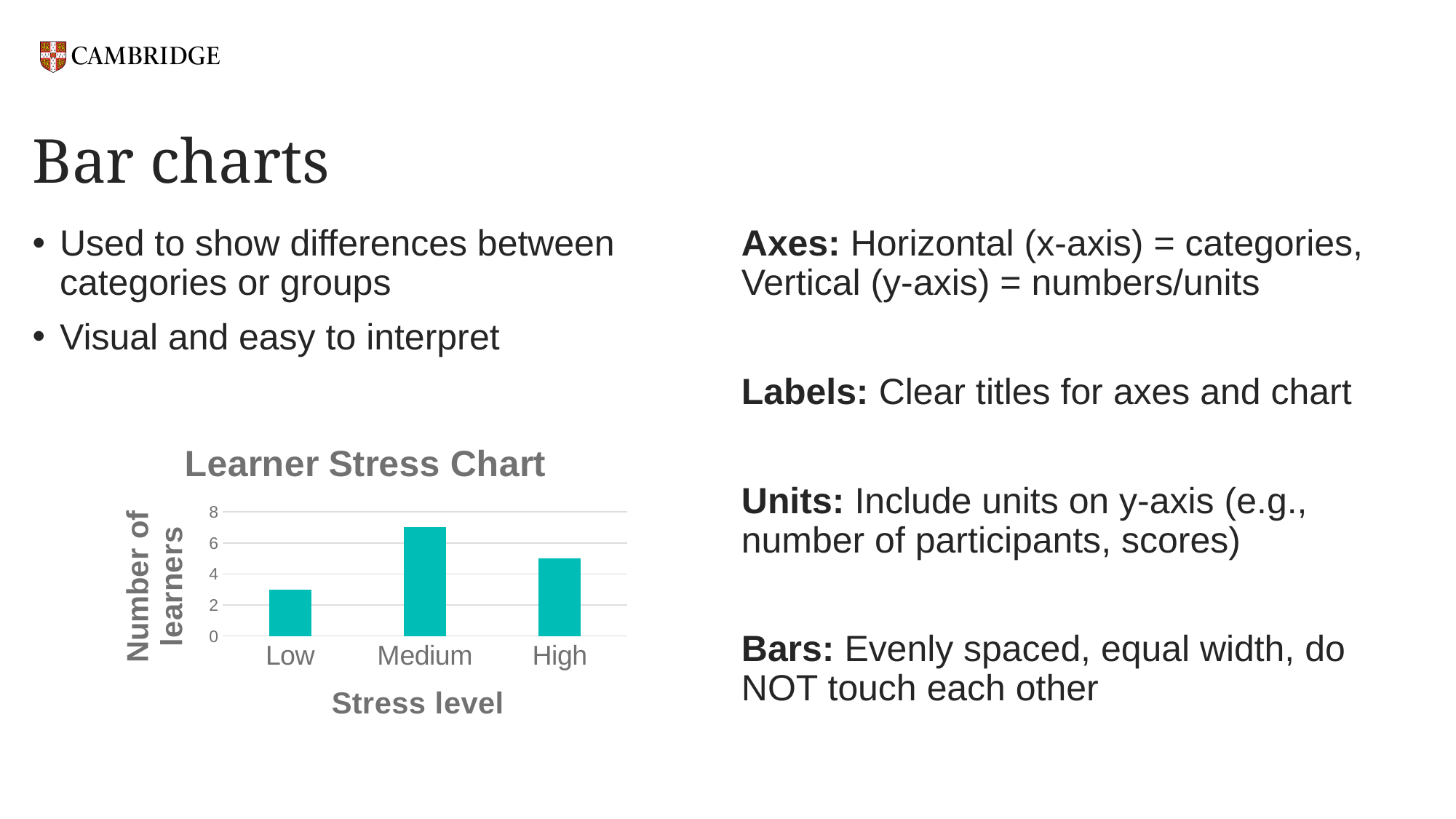
Is the number of learners for Medium greater or less than 6? greater What kind of chart is the Learner Stress Chart? bar chart Which has more learners, High or Low stress level? High Which has more learners, Medium or High stress level? Medium Is the number of learners for High greater or less than 6? less How many stress level categories are shown on the x axis? 3 Is the number of learners for High greater or less than 4? greater Which stress level has the lowest number of learners? Low Which stress level has the highest number of learners? Medium What is the title of the chart on the slide? Learner Stress Chart What is the label on the vertical axis of the chart? Number of learners